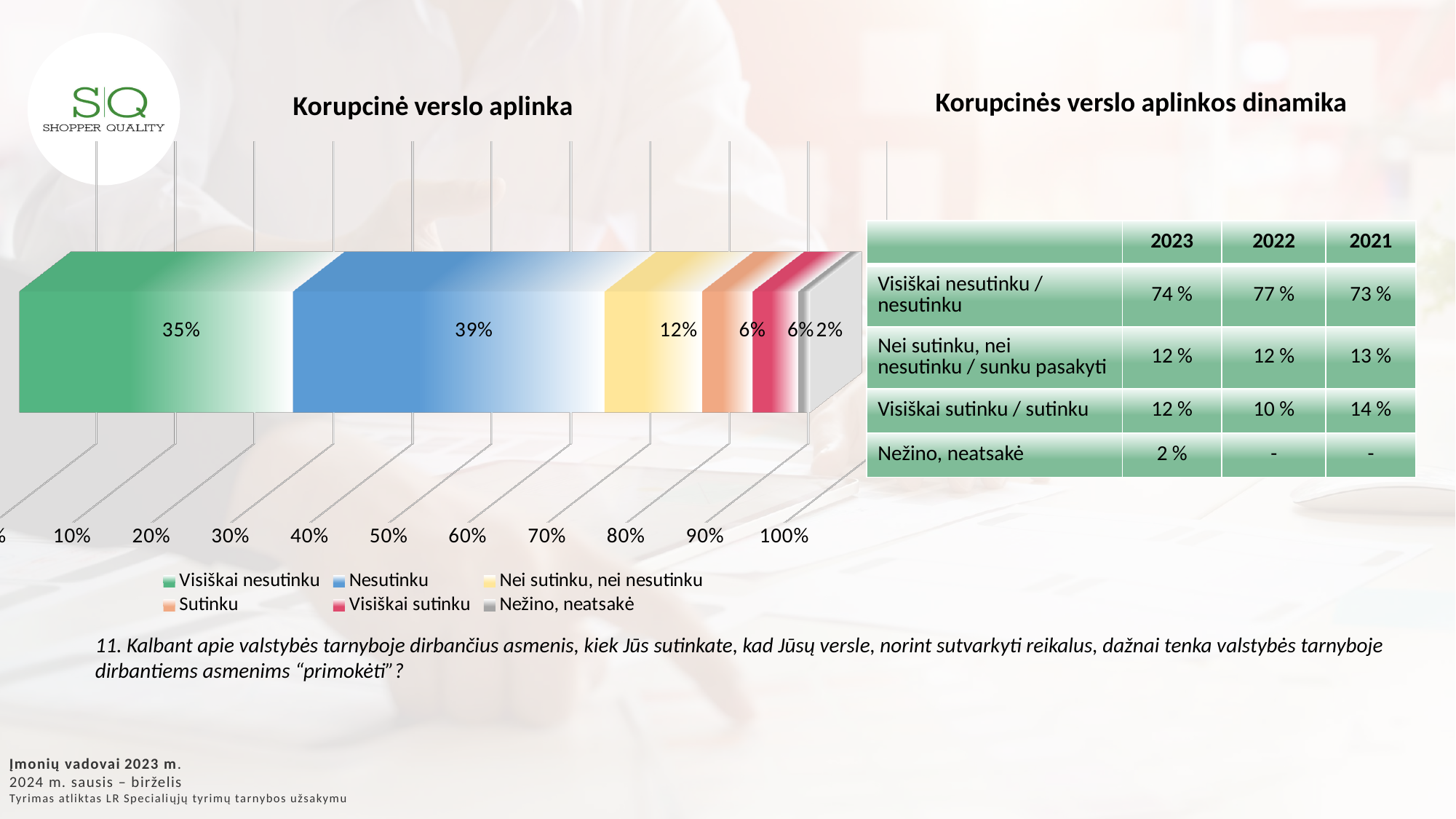
In the chart 'Korupcinė verslo aplinka', which is larger: 'Nei sutinku, nei nesutinku' or 'Sutinku'? Nei sutinku, nei nesutinku In the chart 'Korupcinė verslo aplinka', which series has the largest share? Nesutinku In the chart 'Korupcinė verslo aplinka', what percentage is shown for 'Nežino, neatsakė'? 2% In the chart 'Korupcinė verslo aplinka', what is the difference between the 'Nesutinku' and 'Visiškai nesutinku' values? 4% In the chart 'Korupcinė verslo aplinka', what percentage is shown for 'Nesutinku'? 39% How many series does the legend of the chart 'Korupcinė verslo aplinka' list? 6 In the chart 'Korupcinė verslo aplinka', what is the combined value of 'Visiškai nesutinku' and 'Nesutinku'? 74% In the chart 'Korupcinė verslo aplinka', what colour is the 'Visiškai sutinku' segment? Red In the chart 'Korupcinė verslo aplinka', which series has the smallest share? Nežino, neatsakė What kind of chart is 'Korupcinė verslo aplinka'? Stacked bar chart In the chart 'Korupcinė verslo aplinka', what percentage is shown for 'Visiškai nesutinku'? 35% In the chart 'Korupcinė verslo aplinka', what percentage is shown for 'Nei sutinku, nei nesutinku'? 12%